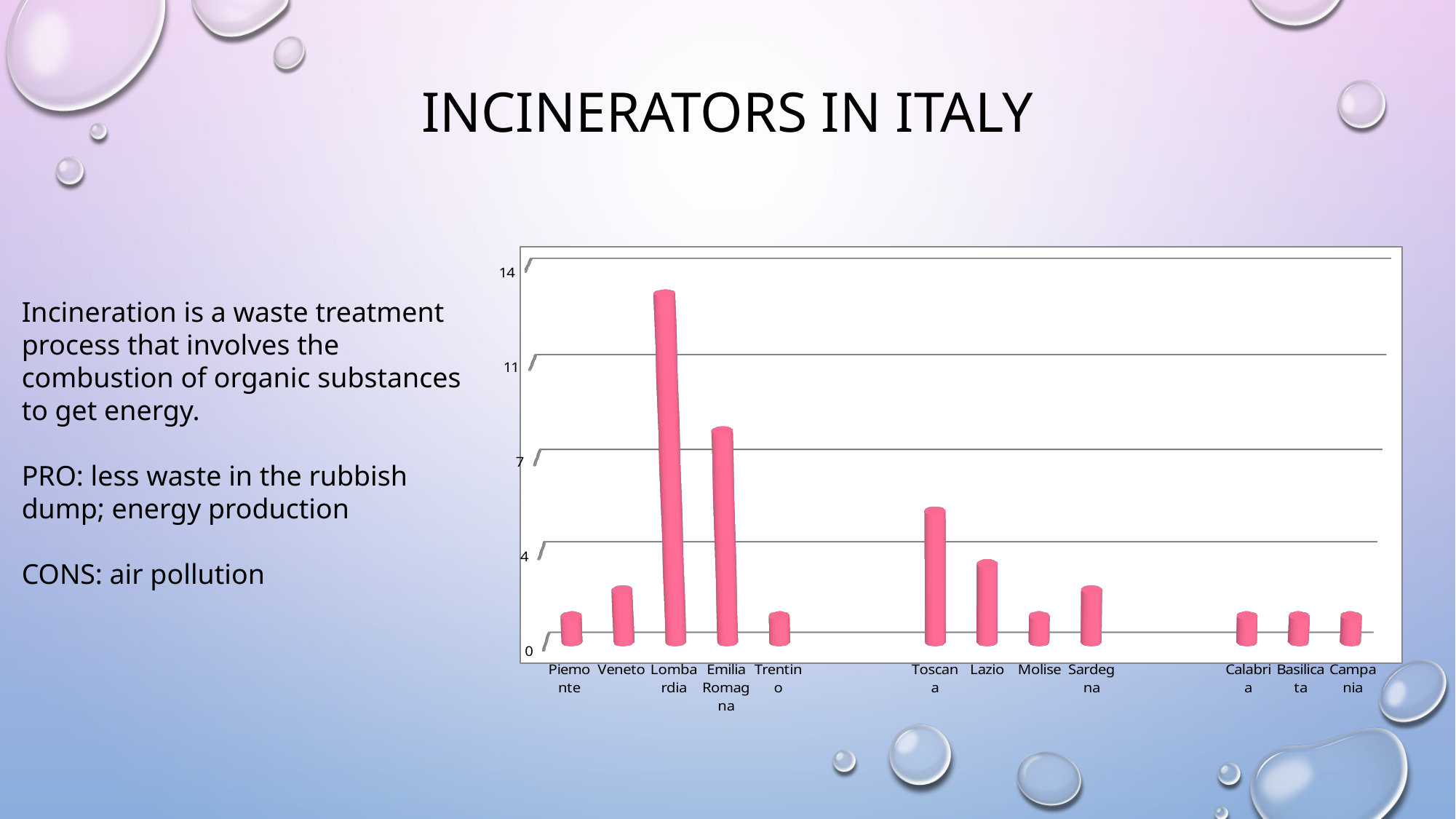
Is the value for Emilia Romagna greater or less than 7? greater Is the value for Toscana greater or less than 7? less Is the value for Toscana greater or less than 4? greater Which has the larger value, Toscana or Lazio? Toscana Which has the larger value, Lombardia or Emilia Romagna? Lombardia What is the title of the slide containing the chart? Incinerators in Italy Which region has the highest bar in the chart? Lombardia What kind of chart is shown on the slide? bar chart How many regions are labeled on the x axis of the chart? 12